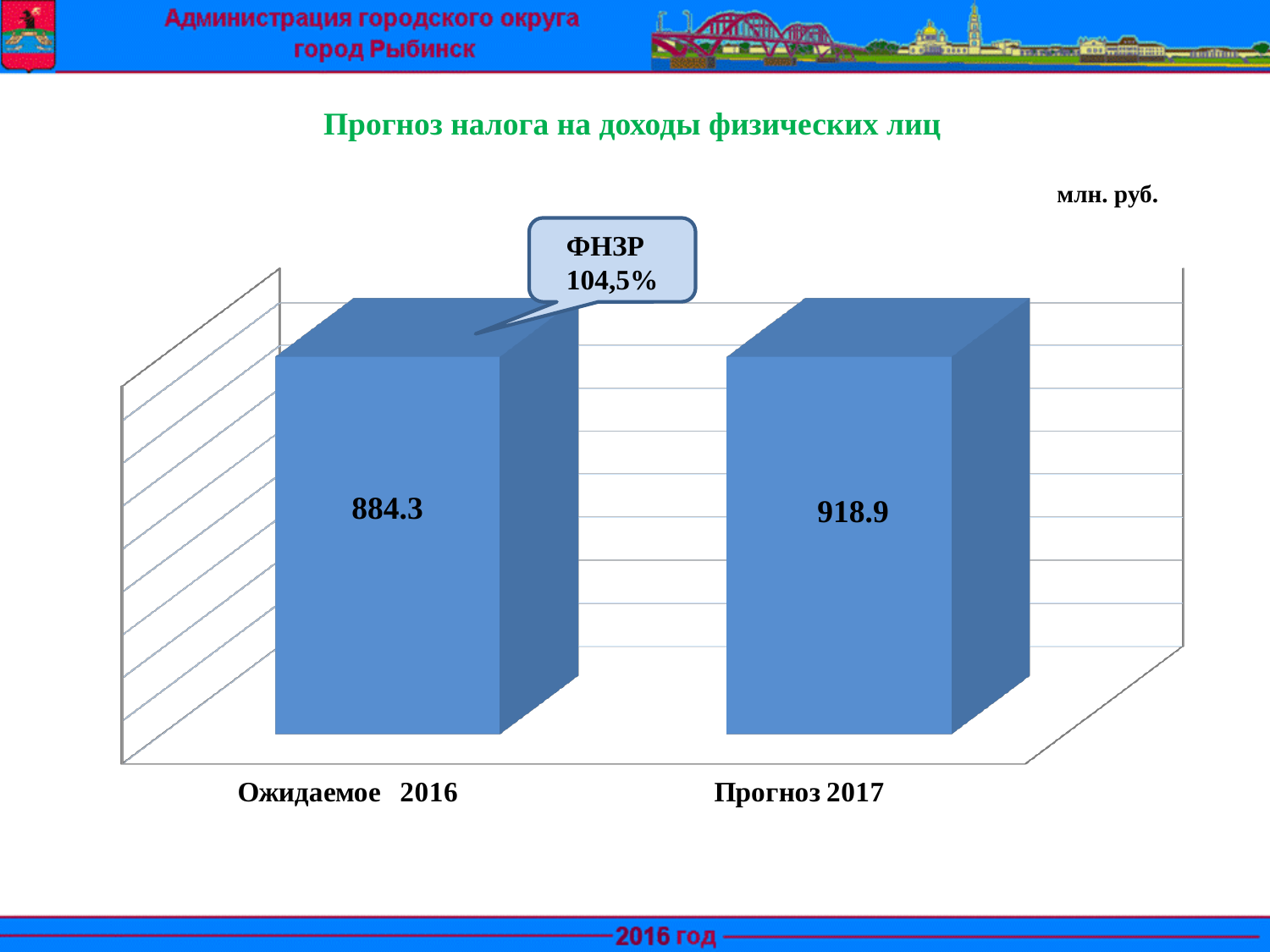
What kind of chart is shown on the slide? bar chart Do the values rise or fall from Ожидаемое 2016 to Прогноз 2017? rise What is the value for Ожидаемое 2016? 884.3 What unit is indicated for the chart values? млн. руб. What is the value for Прогноз 2017? 918.9 Which category has the higher value? Прогноз 2017 What is the title of the chart? Прогноз налога на доходы физических лиц Is the value for Прогноз 2017 larger or smaller than the value for Ожидаемое 2016? larger Which category has the lower value? Ожидаемое 2016 How many categories are shown in the chart? 2 What percentage is shown in the callout labelled ФНЗР? 104,5% What is the difference between the values for Прогноз 2017 and Ожидаемое 2016? 34.6